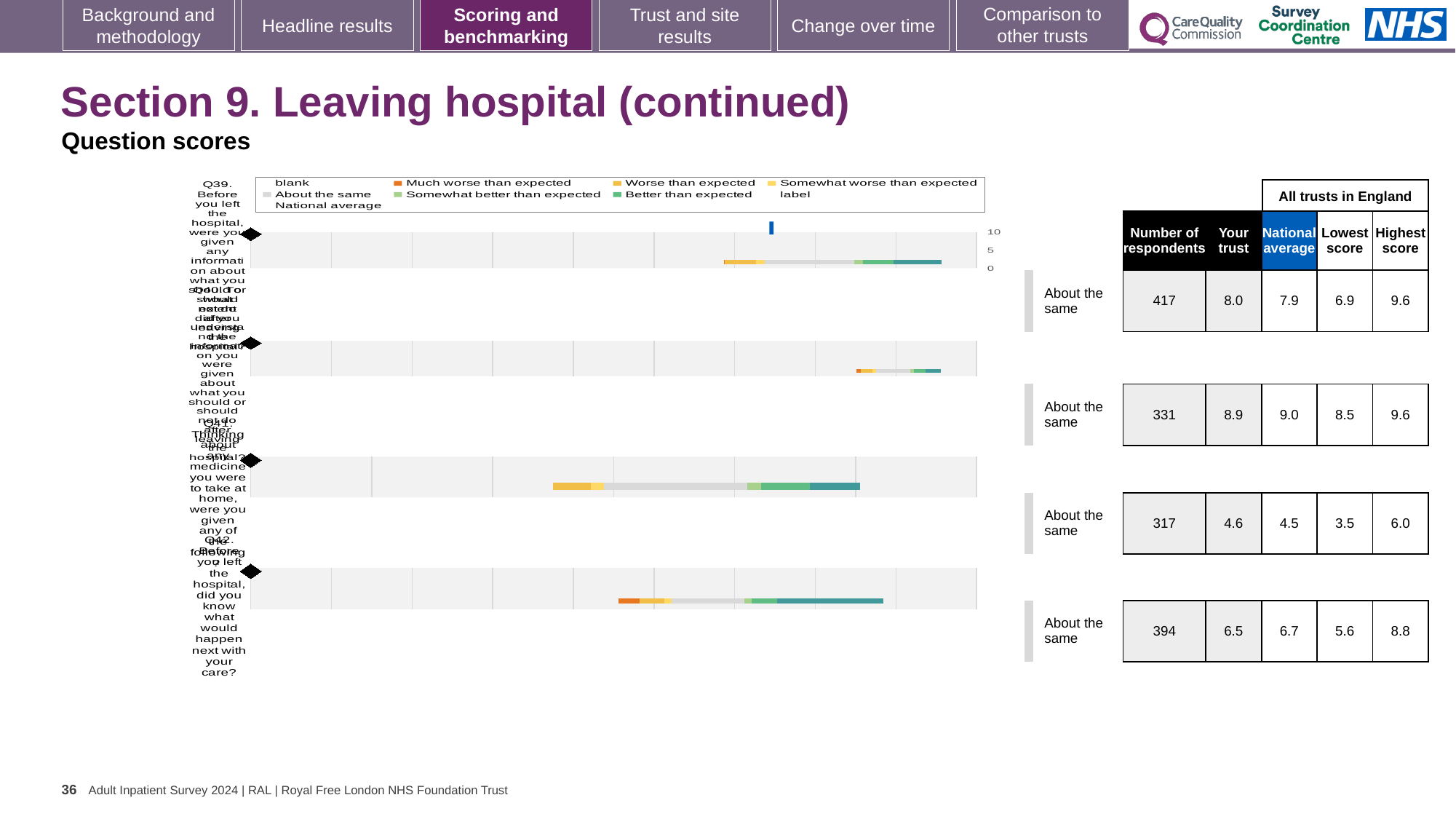
For the top chart (Q39), what is the 'Your trust' score shown in the table? 8.0 In the chart legend, which colour represents 'Better than expected'? teal For the top chart (Q39), what is the national average score shown in the table? 7.9 How many question-score charts are shown on the slide? 4 For the second chart from the top, what is the difference between the highest score (9.6) and the lowest score (8.5) in the table? 1.1 For the bottom chart (Q42), which is larger: the 'Your trust' score or the national average? national average For the third chart from the top, what is the highest score across all trusts in England shown in the table? 6.0 For the bottom chart (Q42), how many respondents are listed in the table? 394 What benchmark category is shown beside each of the four charts? About the same What kind of chart is used for the question scores on this slide? bar chart For the bottom chart (Q42), what is the 'Your trust' score shown in the table? 6.5 In the chart legend, which colour represents 'Much worse than expected'? orange